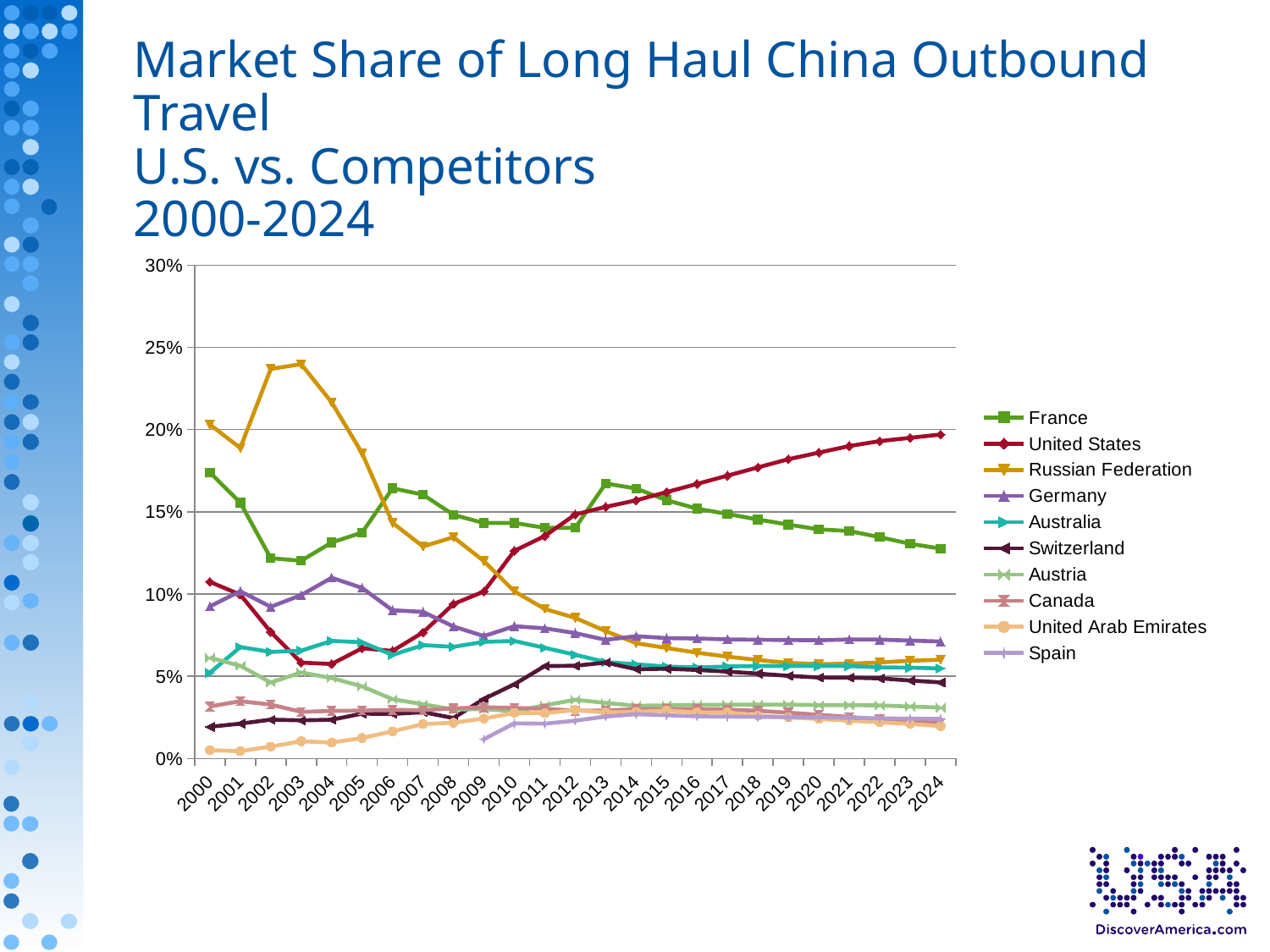
Is the value for Germany in 2004 greater or less than 10%? greater How many series does the legend list? 10 How many years are plotted along the x axis? 25 Is the value for the United States in 2024 greater or less than 15%? greater Is the value for Spain in 2009 greater or less than 5%? less In 2024, which is larger: the value for the United States or the value for France? United States Which series has the highest value in 2003? Russian Federation Does the United States line rise or fall from 2000 to 2024? Rises What is the title of the chart on the slide? Market Share of Long Haul China Outbound Travel U.S. vs. Competitors 2000-2024 What kind of chart is shown on the slide? Line chart In 2000, which is larger: the value for the Russian Federation or the value for France? Russian Federation